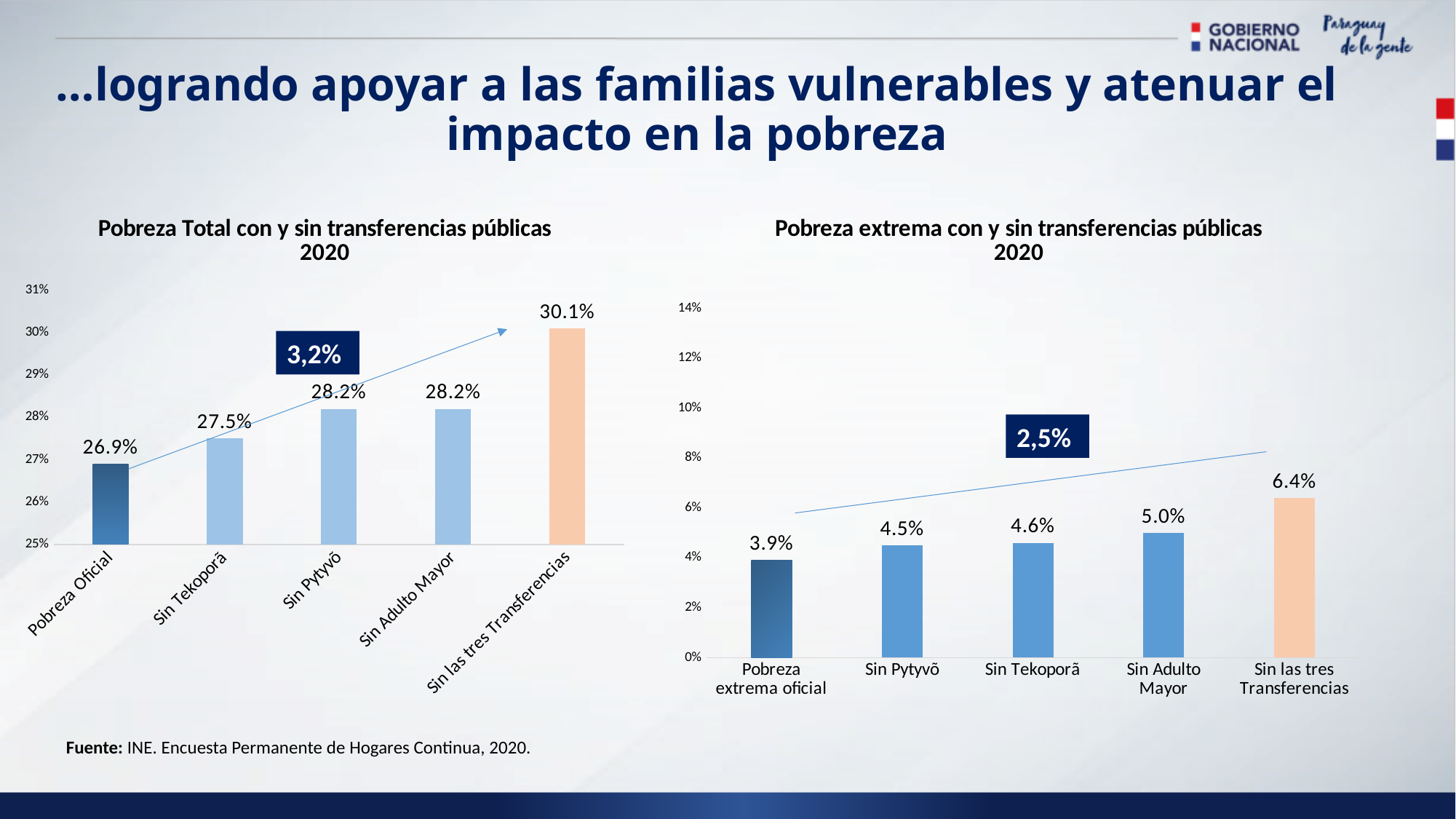
In the 'Pobreza Total con y sin transferencias públicas 2020' chart, what is the value for Pobreza Oficial? 26.9% In the 'Pobreza Total con y sin transferencias públicas 2020' chart, how many categories are shown? 5 In the 'Pobreza extrema con y sin transferencias públicas 2020' chart, is the value for Sin Tekoporã greater or less than 6%? less In the 'Pobreza extrema con y sin transferencias públicas 2020' chart, which category has the highest value? Sin las tres Transferencias In the 'Pobreza extrema con y sin transferencias públicas 2020' chart, do the values rise or fall from left to right? Rise What kind of chart is the 'Pobreza extrema con y sin transferencias públicas 2020' chart? Bar chart In the 'Pobreza extrema con y sin transferencias públicas 2020' chart, what is the value for Sin Adulto Mayor? 5.0% In the 'Pobreza Total con y sin transferencias públicas 2020' chart, what is the value for Sin las tres Transferencias? 30.1% In the 'Pobreza Total con y sin transferencias públicas 2020' chart, which is larger: Sin Tekoporã or Sin Pytyvõ? Sin Pytyvõ In the 'Pobreza Total con y sin transferencias públicas 2020' chart, what is the difference between Sin las tres Transferencias and Pobreza Oficial? 3.2% In the 'Pobreza Total con y sin transferencias públicas 2020' chart, which category has the lowest value? Pobreza Oficial In the 'Pobreza extrema con y sin transferencias públicas 2020' chart, what is the difference between Sin las tres Transferencias and Pobreza extrema oficial? 2.5%